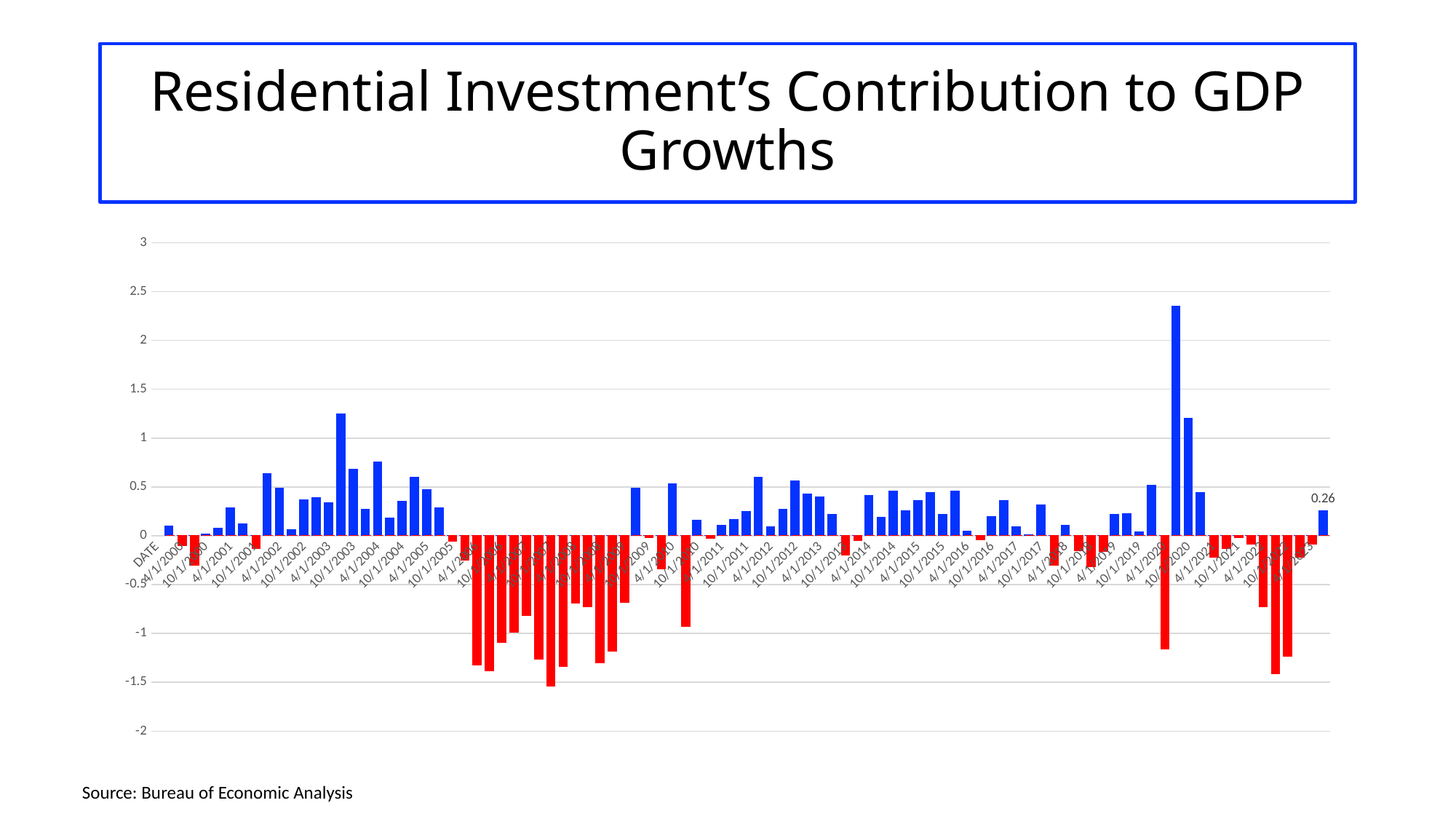
Is the value for 10/1/2020 greater or less than 1.5? less What kind of chart is shown on the slide? bar chart Is the rightmost bar's value (0.26) greater or less than 0.5? less Is the lowest value on the chart greater or less than -1? less What colour are the bars with negative values? red What is the title of the chart? Residential Investment's Contribution to GDP Growths What value is printed as a data label on the rightmost bar of the chart? 0.26 What is the lowest value shown on the vertical axis? -2 What is the highest value shown on the vertical axis? 3